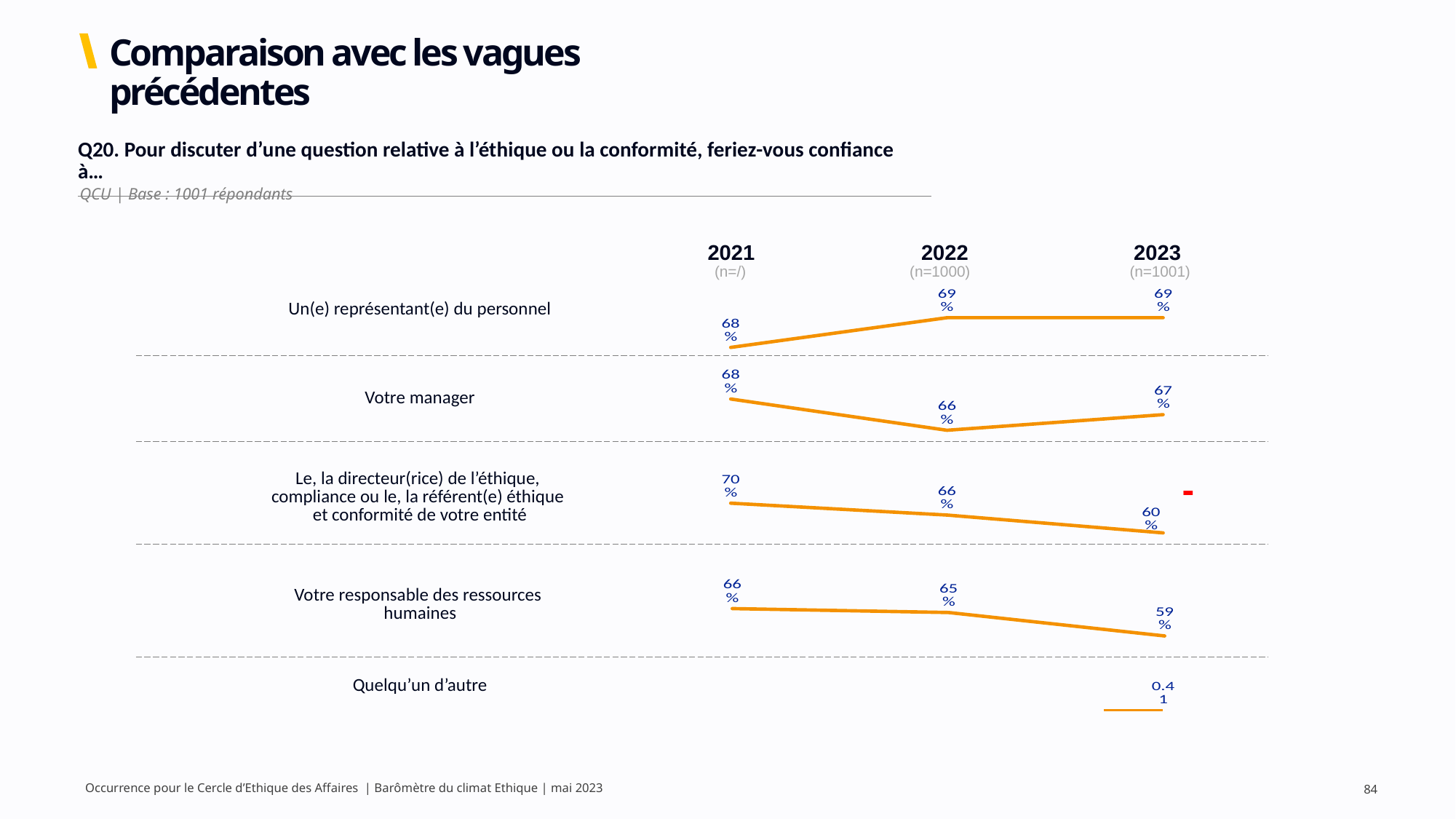
In the 'Votre responsable des ressources humaines' chart, do the values rise or fall from 2021 to 2023? fall What kind of chart is used for each row on the slide? line chart In the 'Votre responsable des ressources humaines' chart, what is the value for 2023? 59% In the 'Votre responsable des ressources humaines' chart, what is the difference between the 2022 and 2023 values? 6 percentage points In the 'Le, la directeur(rice) de l'éthique, compliance ou le, la référent(e) éthique et conformité de votre entité' chart, which year has the highest value? 2021 In the 'Un(e) représentant(e) du personnel' chart, what is the value for 2021? 68% In the 'Votre manager' chart, what is the value for 2022? 66% In the 'Le, la directeur(rice) de l'éthique, compliance ou le, la référent(e) éthique et conformité de votre entité' chart, what is the difference between the 2021 and 2023 values? 10 percentage points In the 'Votre manager' chart, is the 2021 value or the 2023 value larger? 2021 In the 'Le, la directeur(rice) de l'éthique, compliance ou le, la référent(e) éthique et conformité de votre entité' chart, what is the value for 2023? 60% In the 'Votre responsable des ressources humaines' chart, which year has the lowest value? 2023 How many years (waves) are shown as columns across the charts? 3